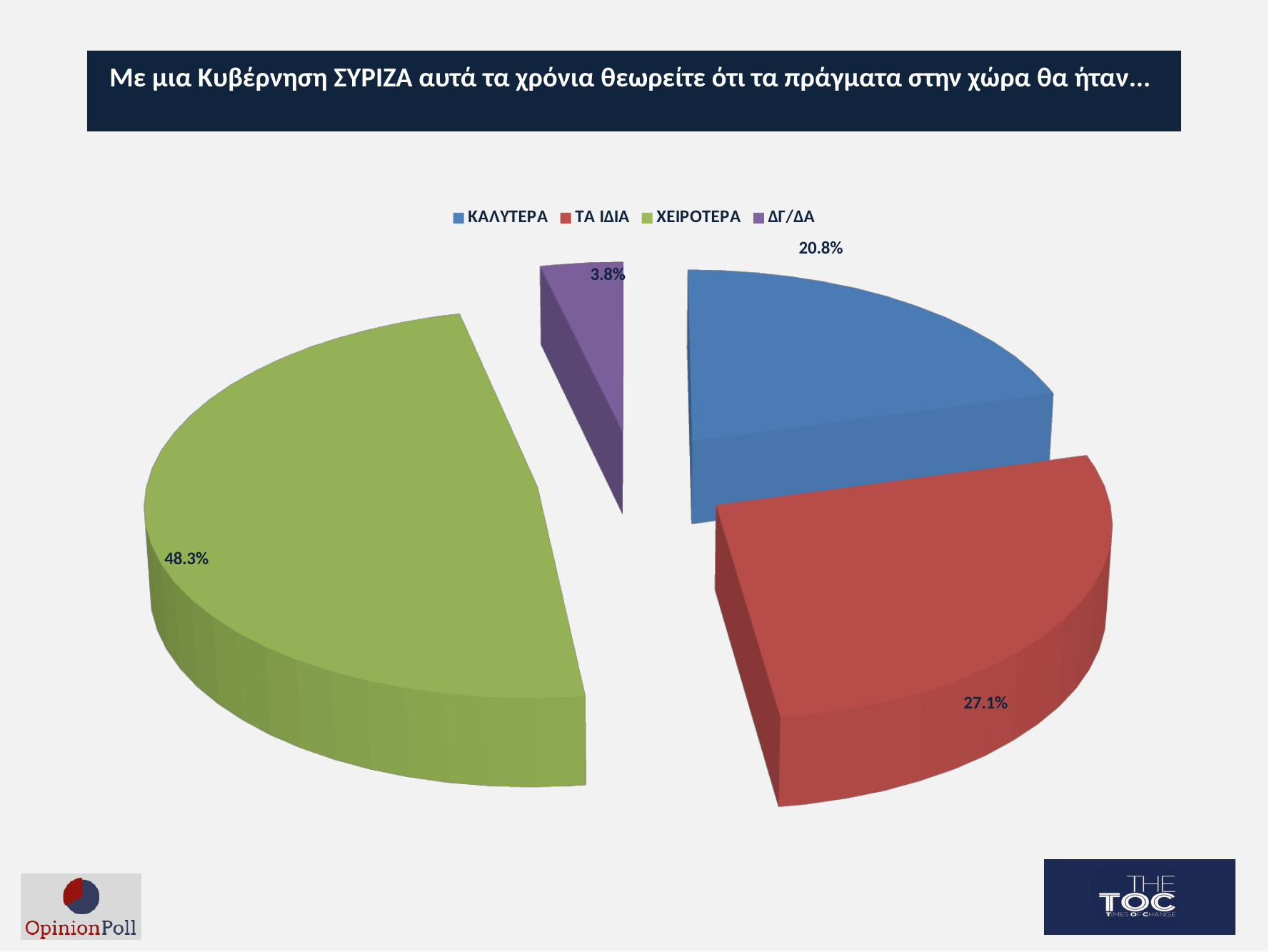
What kind of chart is shown on the slide? Pie chart What is the difference in percentage points between ΤΑ ΙΔΙΑ and ΚΑΛΥΤΕΡΑ? 6.3 What percentage of respondents answered ΚΑΛΥΤΕΡΑ? 20.8% Which response has the largest share of the pie? ΧΕΙΡΟΤΕΡΑ What is the difference in percentage points between ΧΕΙΡΟΤΕΡΑ and ΤΑ ΙΔΙΑ? 21.2 How many categories does the pie chart show? 4 What percentage of respondents answered ΧΕΙΡΟΤΕΡΑ? 48.3% Which response has the smallest share of the pie? ΔΓ/ΔΑ Which is larger, the share for ΚΑΛΥΤΕΡΑ or the share for ΤΑ ΙΔΙΑ? ΤΑ ΙΔΙΑ What percentage of respondents answered ΤΑ ΙΔΙΑ? 27.1% What percentage of respondents answered ΔΓ/ΔΑ? 3.8% What colour is the slice for ΧΕΙΡΟΤΕΡΑ? Green